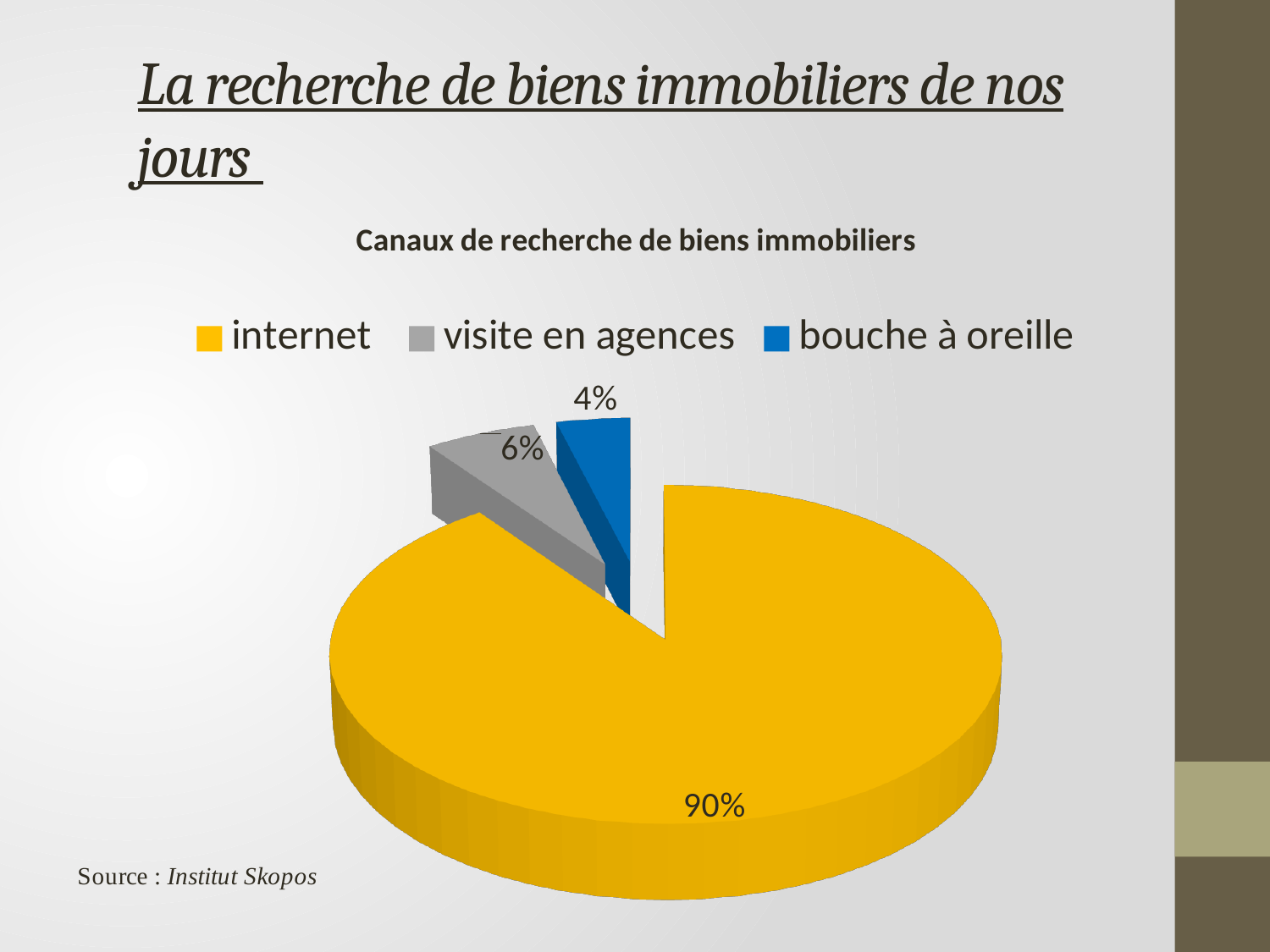
Which is larger, the share for visite en agences or the share for bouche à oreille? visite en agences What kind of chart is shown on the slide? pie chart What is the difference in percentage points between visite en agences and bouche à oreille? 2 What is the title of the chart? Canaux de recherche de biens immobiliers How many slices does the pie chart have? 3 Which category has the smallest slice of the pie? bouche à oreille What is the difference in percentage points between internet and visite en agences? 84 What share of the pie does visite en agences account for? 6% Which category has the largest slice of the pie? internet What colour is the slice for internet? yellow What share of the pie does internet account for? 90% What share of the pie does bouche à oreille account for? 4%